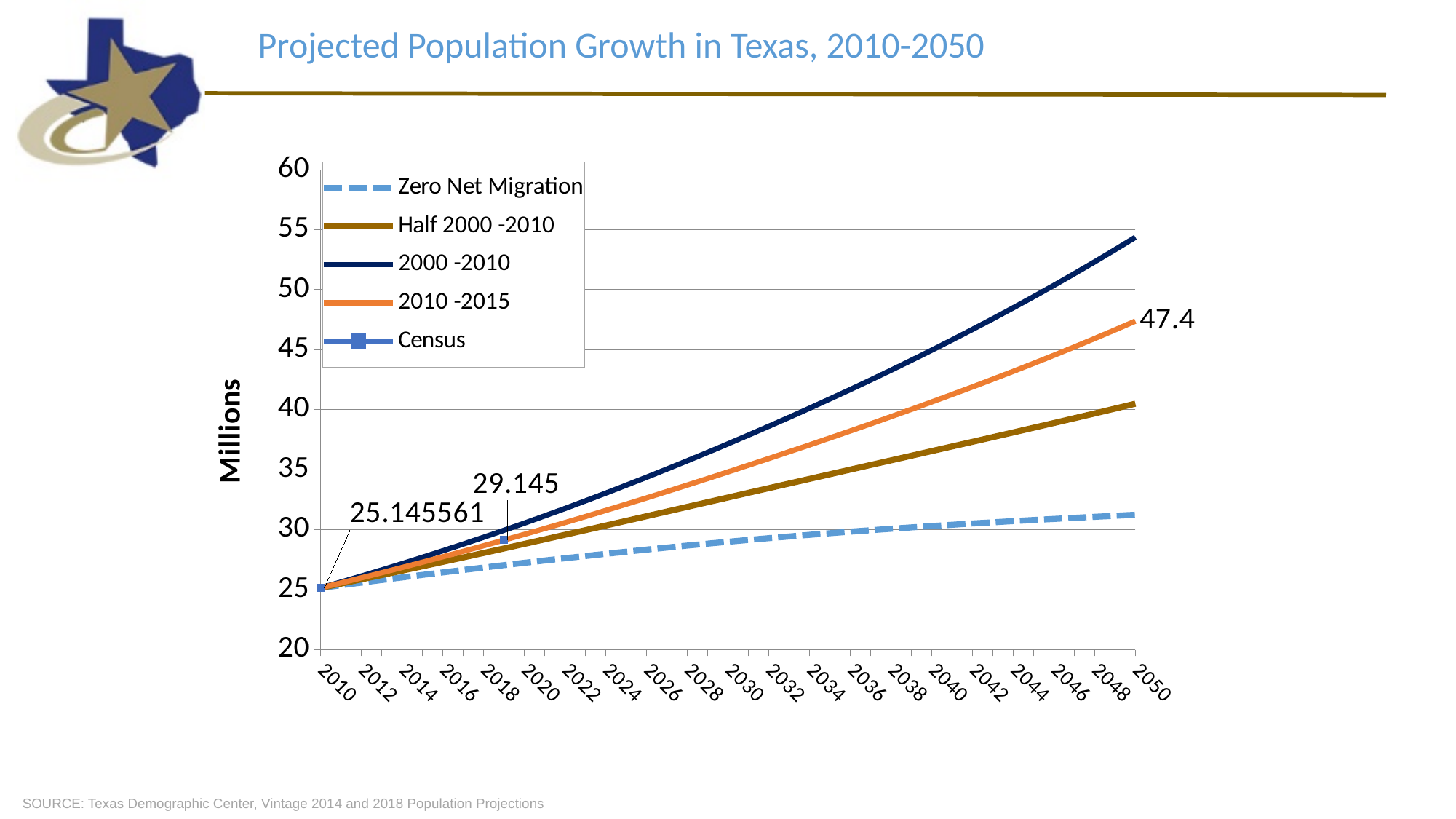
Which series has the lowest value in 2050? Zero Net Migration Which series reaches the highest value in 2050? 2000 -2010 What is the label on the vertical axis? Millions How many series does the legend list? 5 What value is labelled at the end of the 2010 -2015 line in 2050? 47.4 What is the Census value labelled for 2010? 25.145561 Is the value of the 2000 -2010 series in 2050 greater or less than 50? greater Do the projection lines rise or fall from 2010 to 2050? rise What kind of chart is shown on the slide? line chart In 2050, which is larger: the 2010 -2015 series or the Half 2000 -2010 series? 2010 -2015 Is the value of the Half 2000 -2010 series in 2050 greater or less than 45? less